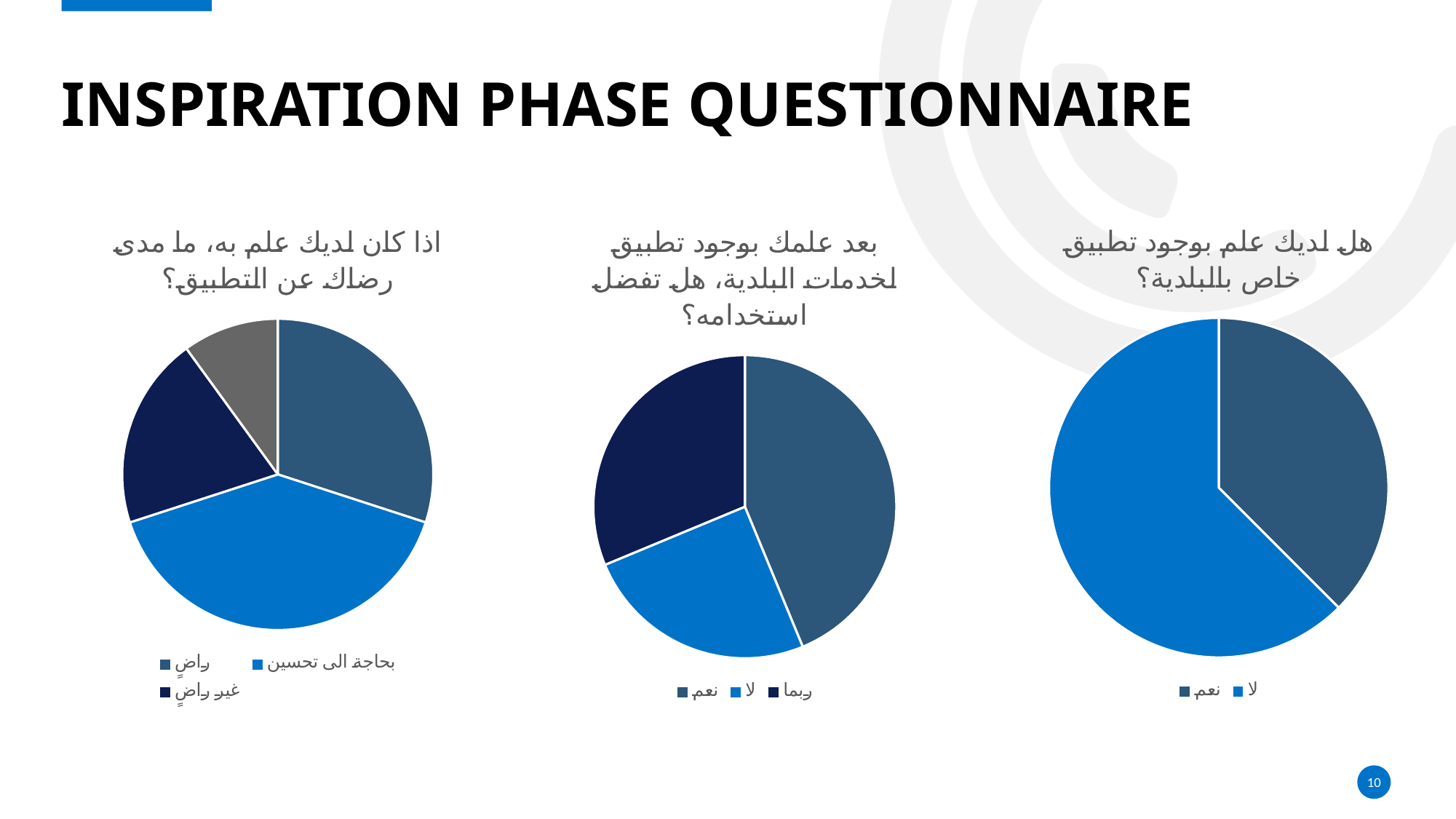
In the left-hand chart ("اذا كان لديك علم به، ما مدى رضاك عن التطبيق؟"), which slice is larger, راضٍ or غير راضٍ? راضٍ What kind of chart is the right-hand chart titled "هل لديك علم بوجود تطبيق خاص بالبلدية؟"? Pie chart How many pie charts are shown on the slide? 3 In the left-hand chart ("اذا كان لديك علم به، ما مدى رضاك عن التطبيق؟"), which legend category has the largest slice? بحاجة الى تحسين In the middle chart ("بعد علمك بوجود تطبيق لخدمات البلدية، هل تفضل استخدامه؟"), which category has the largest slice? نعم In the right-hand chart ("هل لديك علم بوجود تطبيق خاص بالبلدية؟"), which category has the largest slice? لا In the right-hand chart ("هل لديك علم بوجود تطبيق خاص بالبلدية؟"), which slice is larger, نعم or لا? لا How many slices does the middle chart ("بعد علمك بوجود تطبيق لخدمات البلدية، هل تفضل استخدامه؟") have? 3 How many slices does the left-hand chart ("اذا كان لديك علم به، ما مدى رضاك عن التطبيق؟") have? 4 How many entries does the legend of the right-hand chart ("هل لديك علم بوجود تطبيق خاص بالبلدية؟") list? 2 In the middle chart ("بعد علمك بوجود تطبيق لخدمات البلدية، هل تفضل استخدامه؟"), which category has the smallest slice? لا In the middle chart ("بعد علمك بوجود تطبيق لخدمات البلدية، هل تفضل استخدامه؟"), which slice is larger, نعم or ربما? نعم